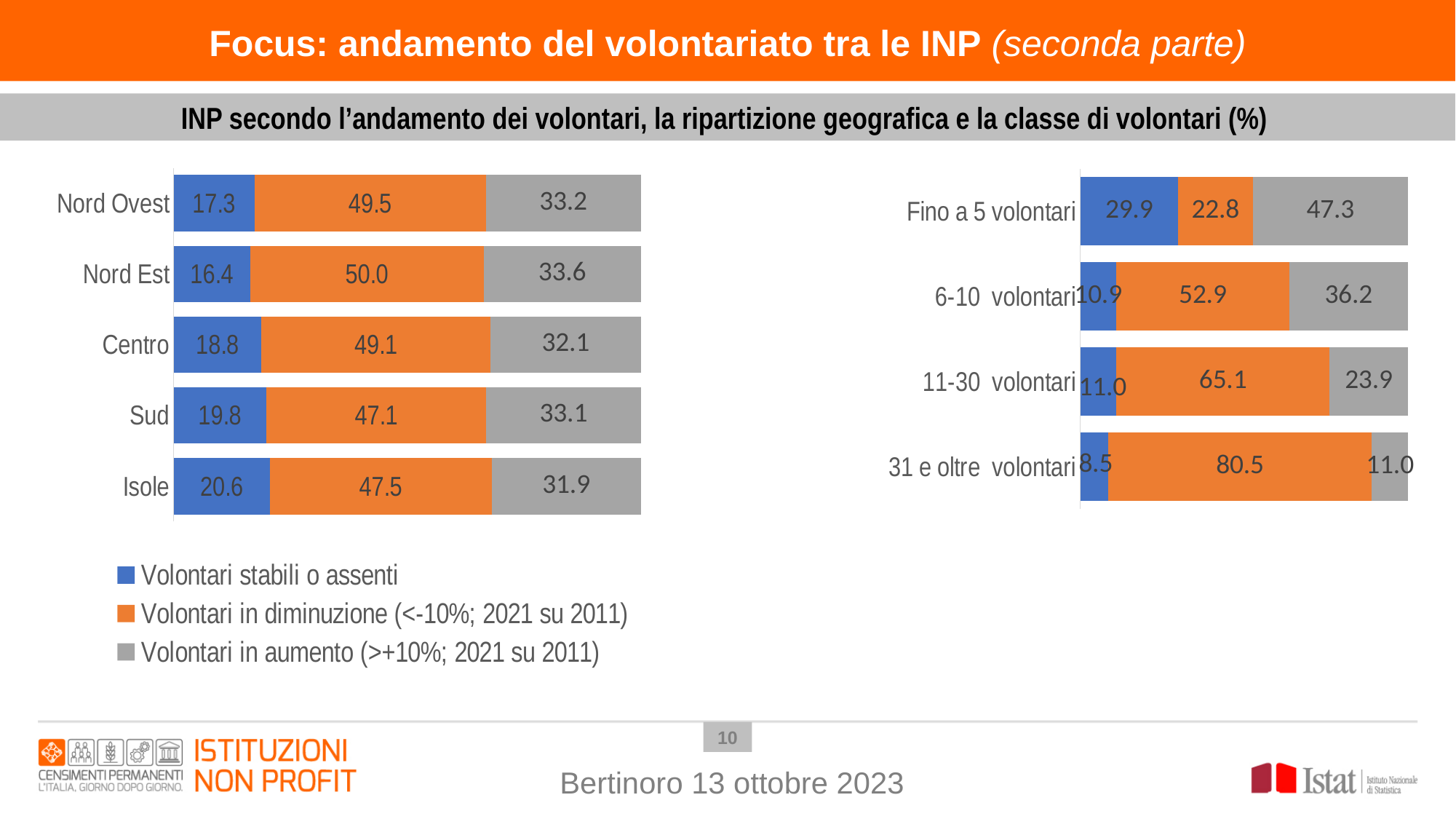
How many series does the legend list? 3 In the left chart (by geographic area), what is the difference between the 'Volontari in diminuzione' values for Nord Est and Sud? 2.9 What kind of chart is the right chart (by volunteer class)? Stacked bar chart In the right chart (by volunteer class), which is larger: 'Volontari stabili o assenti' for 'Fino a 5 volontari' or for '6-10 volontari'? Fino a 5 volontari In the right chart (by volunteer class), what is the value of 'Volontari in diminuzione' for '31 e oltre volontari'? 80.5 In the left chart (by geographic area), which area has the highest value for 'Volontari stabili o assenti'? Isole In the left chart (by geographic area), what is the value of 'Volontari in diminuzione' for Nord Est? 50.0 How many geographic areas are shown in the left chart? 5 In the right chart (by volunteer class), which class has the lowest value for 'Volontari in aumento'? 31 e oltre volontari In the right chart (by volunteer class), what is the value of 'Volontari in aumento' for 'Fino a 5 volontari'? 47.3 Which colour represents 'Volontari in aumento (>+10%; 2021 su 2011)' in the legend? Grey In the left chart (by geographic area), what is the value of 'Volontari stabili o assenti' for Isole? 20.6